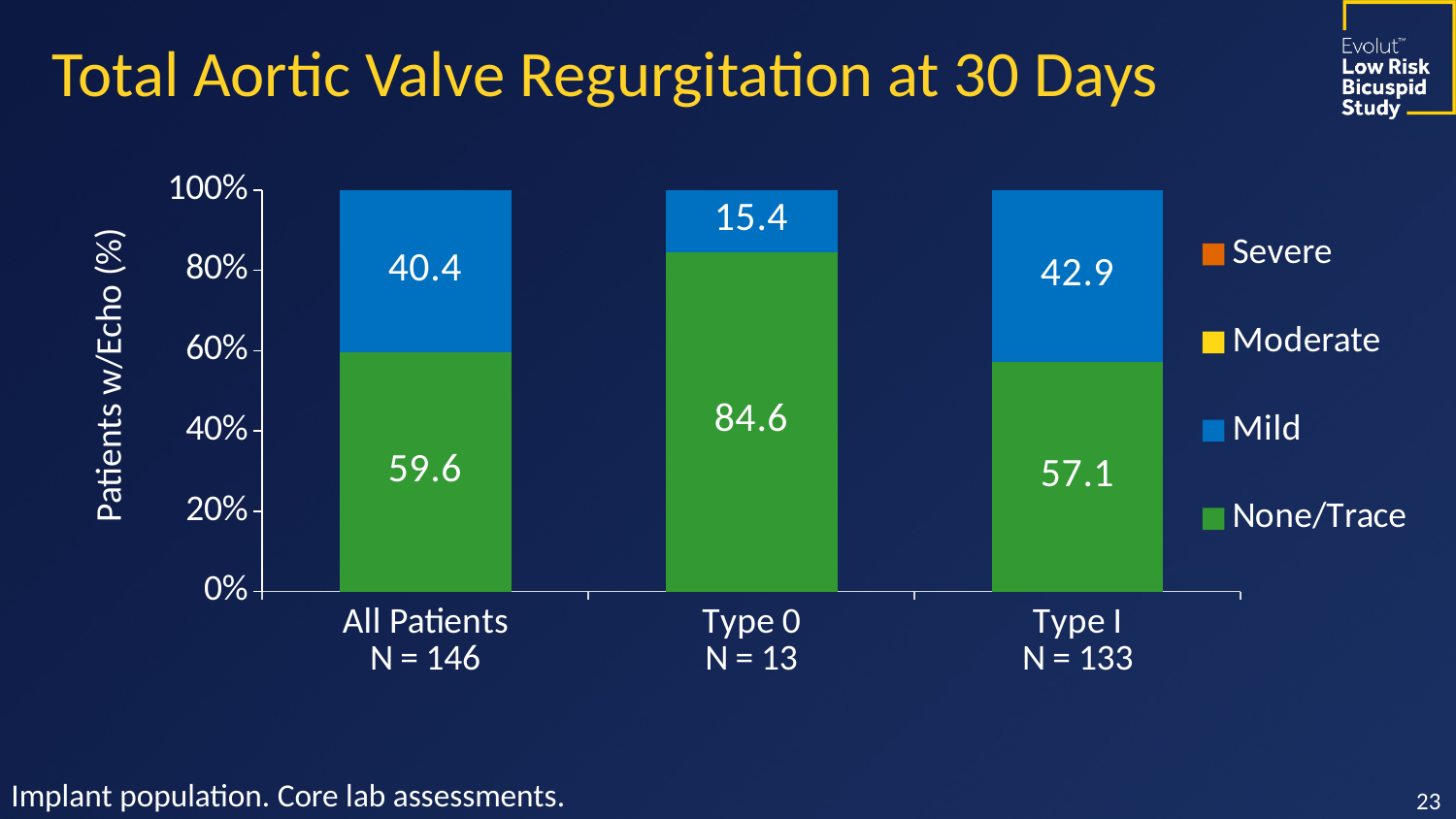
Which category has the lowest Mild value? Type 0 How many categories are shown on the x axis? 3 What is the None/Trace value for All Patients? 59.6 What is the Mild value for Type I? 42.9 What is the None/Trace value for Type 0? 84.6 What is the title of the chart? Total Aortic Valve Regurgitation at 30 Days What is the Mild value for All Patients? 40.4 Is the Mild value larger for All Patients or for Type I? Type I Which category has the highest None/Trace value? Type 0 How many series does the legend list? 4 What is the difference between the None/Trace values for Type 0 and Type I? 27.5 What kind of chart is shown on the slide? Stacked bar chart